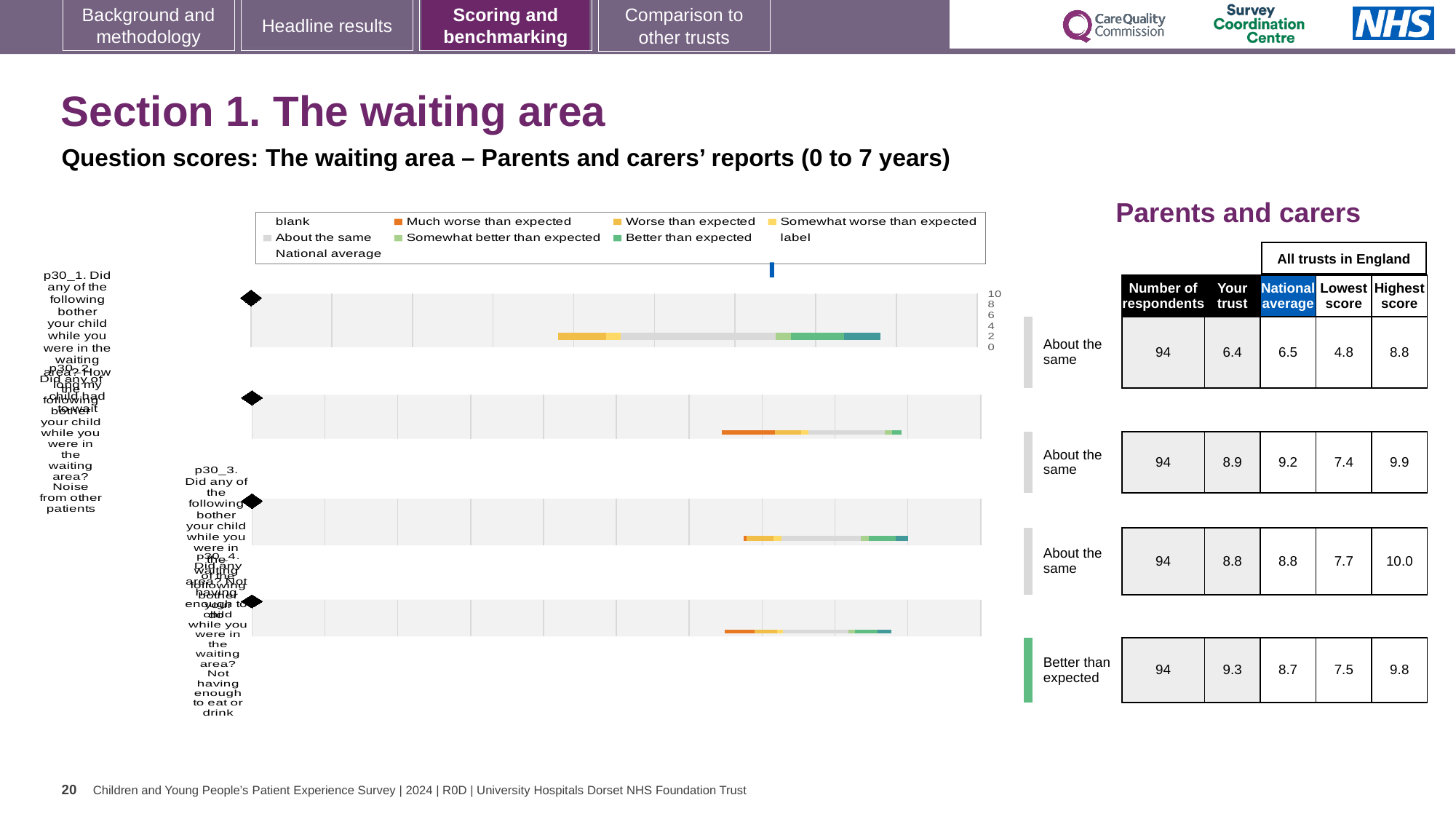
In the table next to the chart, which question has the highest 'Your trust' score? p30_4 (Not having enough to eat or drink), 9.3 In the table next to the chart, is the 'Your trust' score for the second question (p30_2) larger or smaller than its national average? smaller Which legend entry is shown in orange? Much worse than expected In the table next to the chart, which question has the lowest 'Your trust' score? p30_1 (Noise from other patients), 6.4 In the table next to the chart, what is the 'Your trust' score for the first question (p30_1, noise from other patients)? 6.4 How many entries does the chart legend list? 9 In the table next to the chart, what is the national average for the fourth question (p30_4, not having enough to eat or drink)? 8.7 What kind of chart is shown on the slide? bar chart In the table next to the chart, what is the difference between the highest score and the lowest score for the third question (p30_3)? 2.3 How many question bars are plotted in the chart? 4 What is the maximum value shown on the chart's axis? 10 How many respondents are listed for each question in the table next to the chart? 94